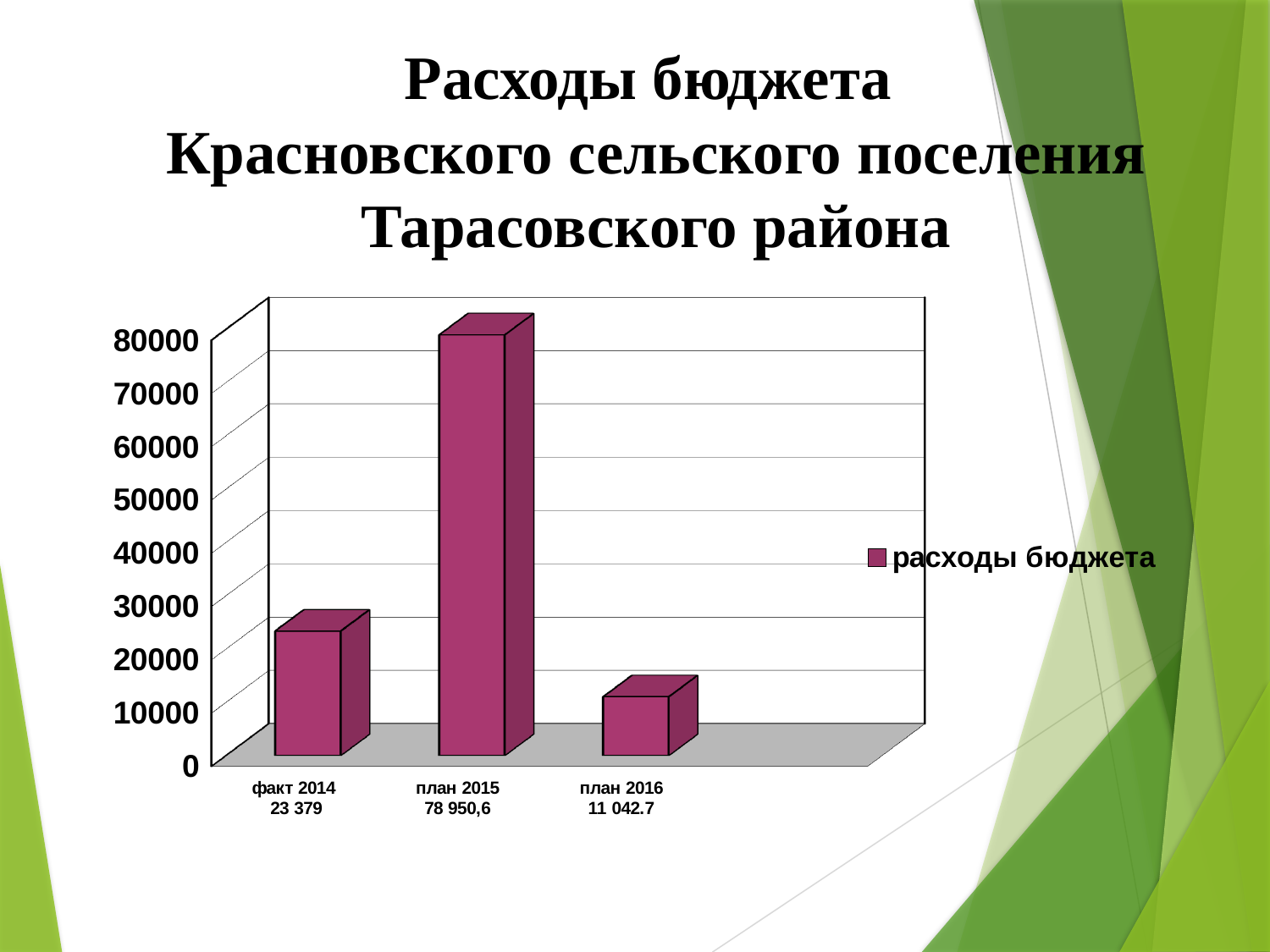
How many categories are shown on the x axis? 3 How many series does the legend list? 1 Which category has the highest value? план 2015 Which category has the lowest value? план 2016 Is the value for план 2015 greater or less than 70000? greater What value is shown for факт 2014? 23 379 Is the value for план 2016 greater or less than 20000? less Which is larger, the value for факт 2014 or the value for план 2016? факт 2014 What kind of chart is shown on the slide? bar chart What value is shown for план 2016? 11 042.7 What is the name of the series in the legend? расходы бюджета What value is shown for план 2015? 78 950,6